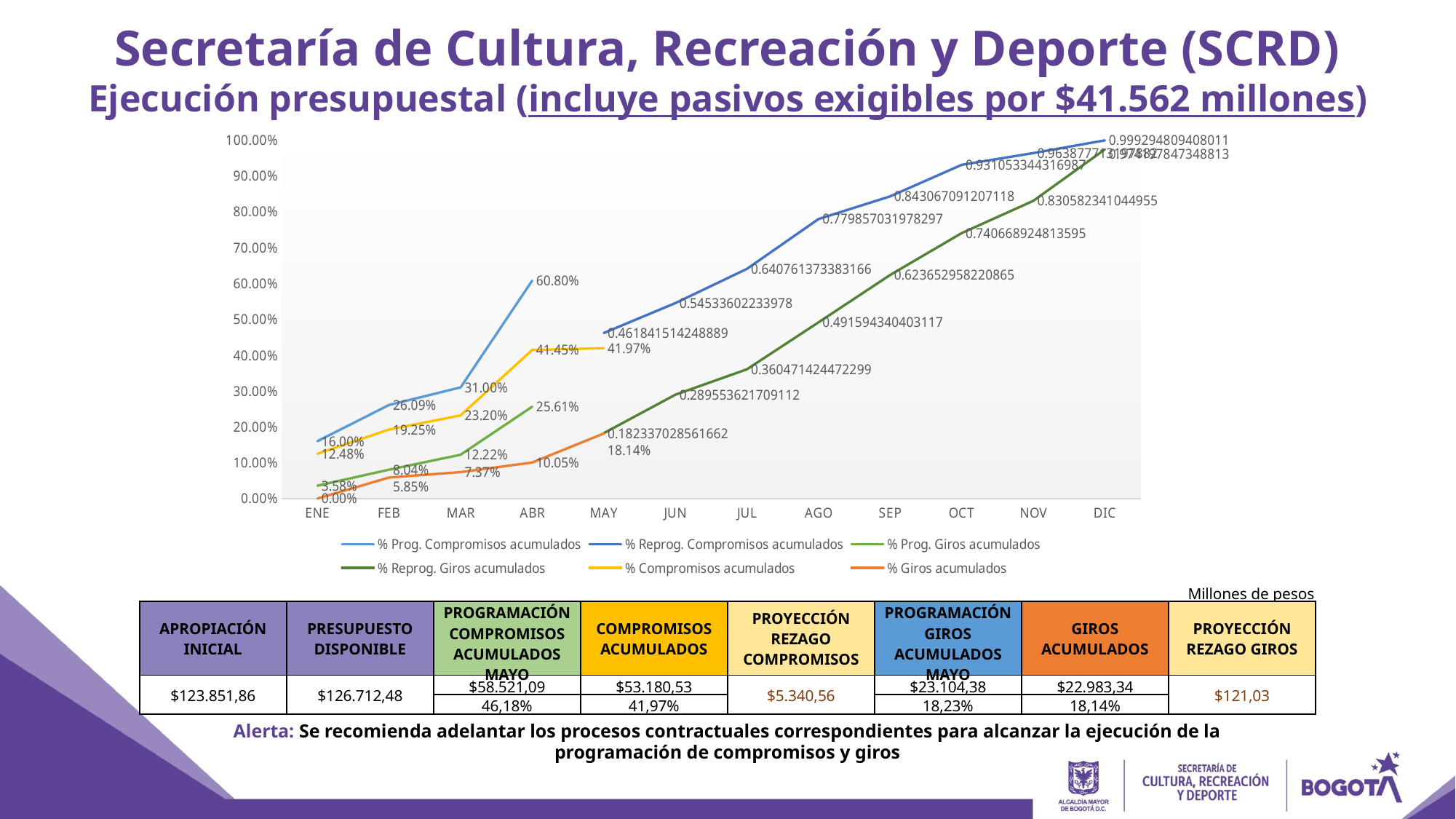
What is the value of % Reprog. Compromisos acumulados in DIC? 0.999294809408011 In FEB, which is larger: % Prog. Compromisos acumulados or % Compromisos acumulados? % Prog. Compromisos acumulados How many series does the chart legend list? 6 What kind of chart is shown on the slide? line chart Does % Reprog. Giros acumulados rise or fall from MAY to DIC? rise Is the value for % Reprog. Compromisos acumulados in AGO greater or less than 70.00%? greater How many months are shown along the x axis of the chart? 12 What is the value of % Compromisos acumulados in MAY? 41.97% What is the value of % Prog. Compromisos acumulados in ABR? 60.80% What is the value of % Reprog. Giros acumulados in SEP? 0.623652958220865 What is the difference between % Prog. Compromisos acumulados and % Compromisos acumulados in ABR? 19.35 percentage points What is the value of % Giros acumulados in MAY? 18.14%